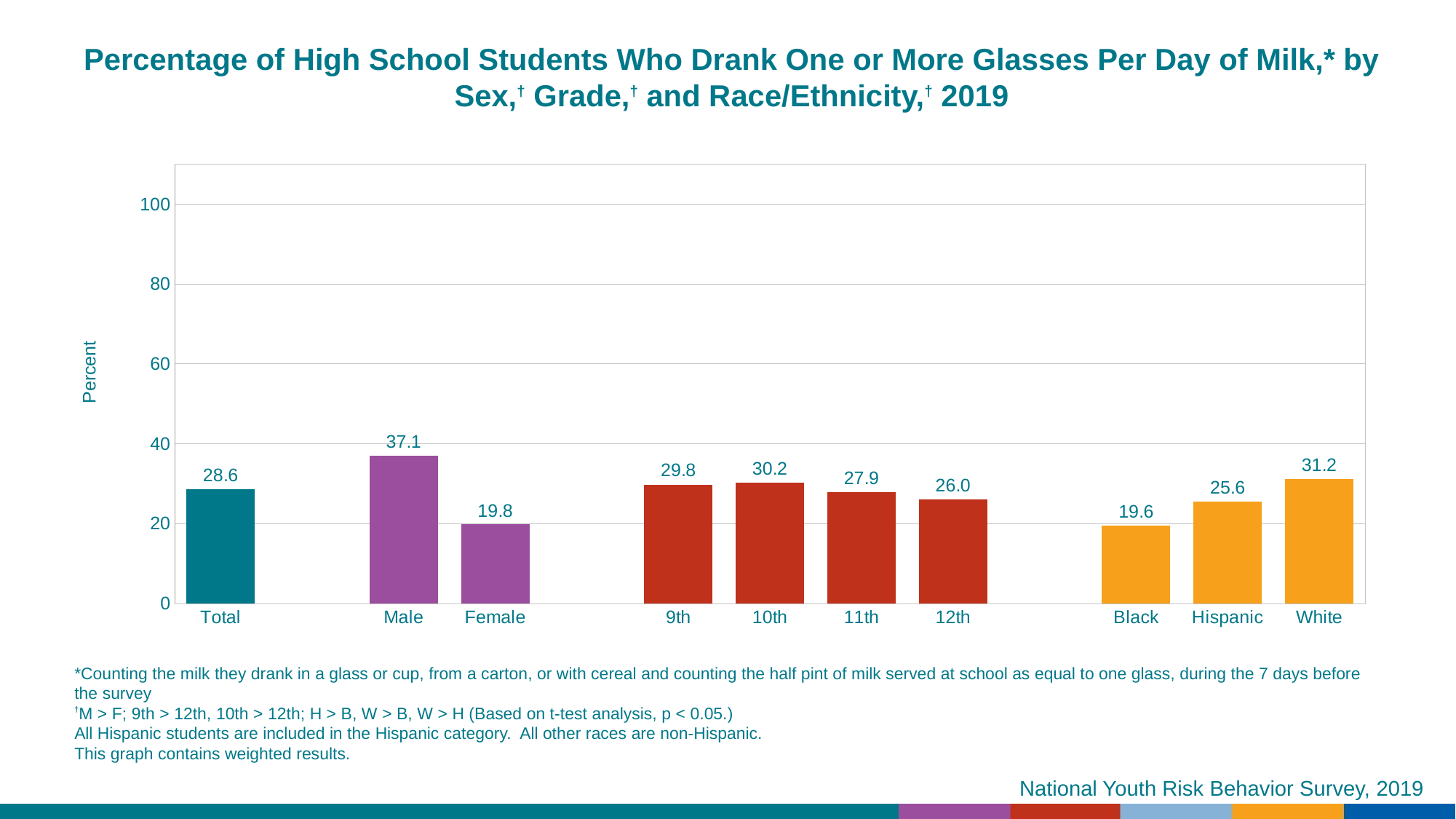
Do the values rise or fall across the grade categories from 10th to 12th? fall Which is larger, the value for 9th grade or 12th grade? 9th What is the value for Female? 19.8 Is the value for White greater or less than 40? less Which category has the lowest value? Black How many bars are shown in the chart? 10 What is the value for Total? 28.6 What kind of chart is shown on the slide? bar chart What is the value for Hispanic? 25.6 What is the value for 11th grade? 27.9 What is the difference between the Male and Female values? 17.3 Which category has the highest value? Male